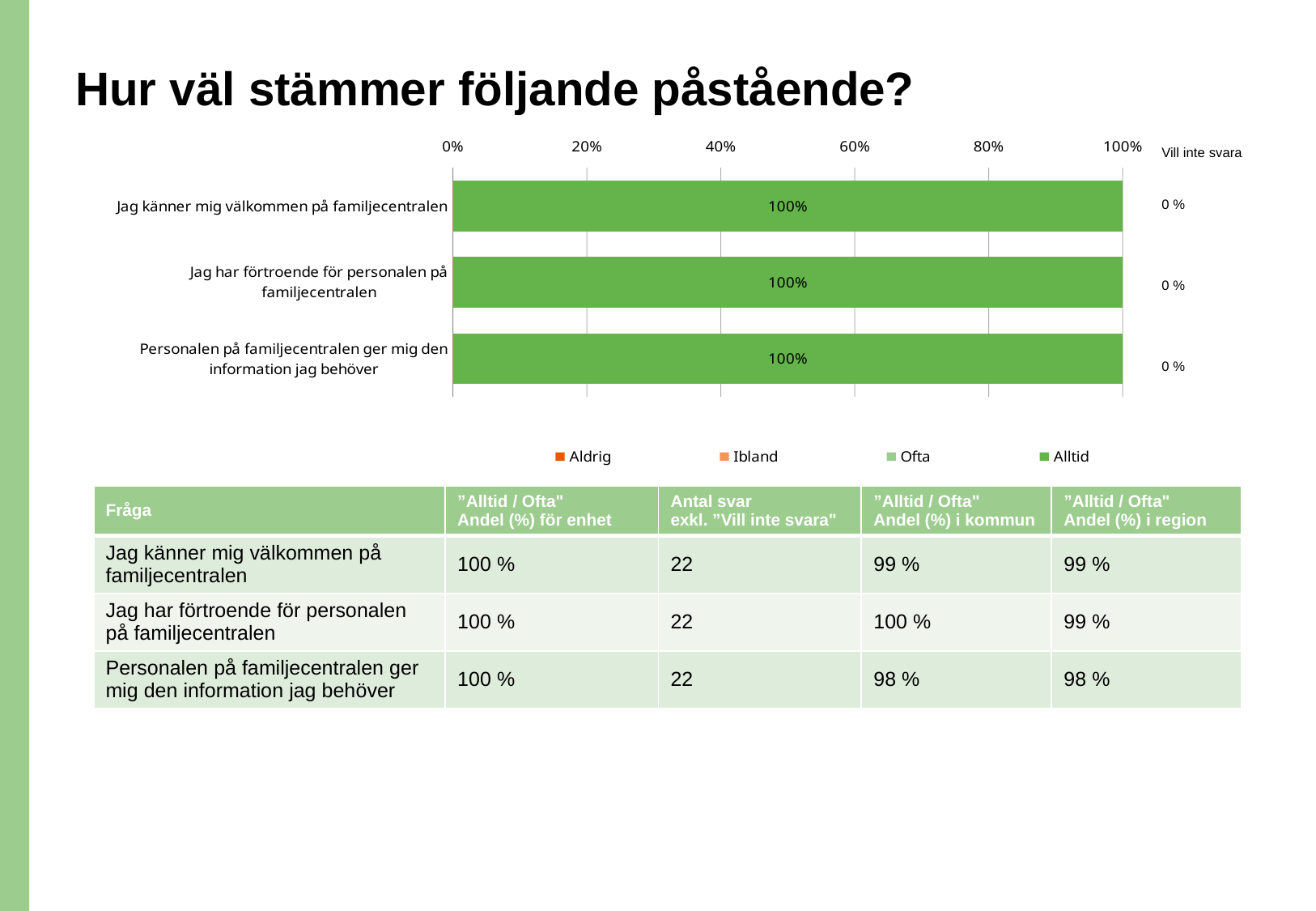
Is the value for "Jag har förtroende för personalen på familjecentralen" greater or less than 80%? greater What value is labelled on the bar for "Jag känner mig välkommen på familjecentralen"? 100% What kind of chart is shown on the slide? bar chart What is the first series listed in the chart legend? Aldrig What is the highest value shown on the chart's percentage axis? 100% How many series does the chart legend list? 4 What value is labelled on the bar for "Personalen på familjecentralen ger mig den information jag behöver"? 100% What value is labelled on the bar for "Jag har förtroende för personalen på familjecentralen"? 100% What is the "Vill inte svara" value shown next to the bar for "Jag känner mig välkommen på familjecentralen"? 0 % Which series in the legend is shown in dark green? Alltid How many categories (statements) are plotted in the chart? 3 What is the "Vill inte svara" value shown next to the bar for "Personalen på familjecentralen ger mig den information jag behöver"? 0 %